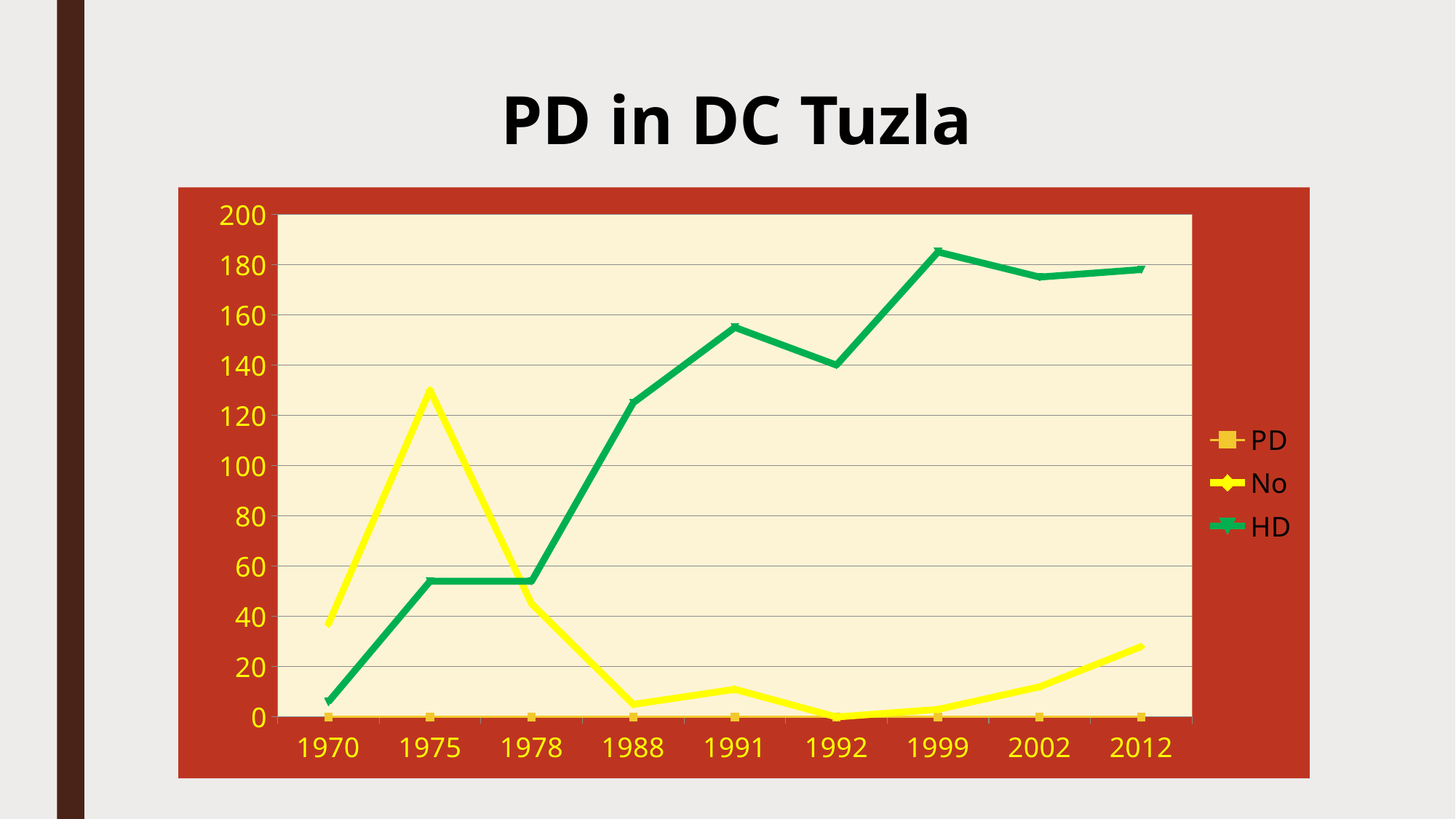
Is the value for HD in 1992 greater or less than 160? less Which series has the larger value in 1991, HD or No? HD In which year is the HD series at its lowest value? 1970 Is the value for HD in 1999 greater or less than 180? greater How many series does the legend list? 3 In which year does the No series reach its highest value? 1975 What kind of chart is shown on the slide? line chart Does the HD series generally rise or fall from 1970 to 2012? rise In which year does the HD series reach its highest value? 1999 Is the value for No in 1975 greater or less than 120? greater Which series has the larger value in 1975, HD or No? No How many years are shown on the x axis? 9